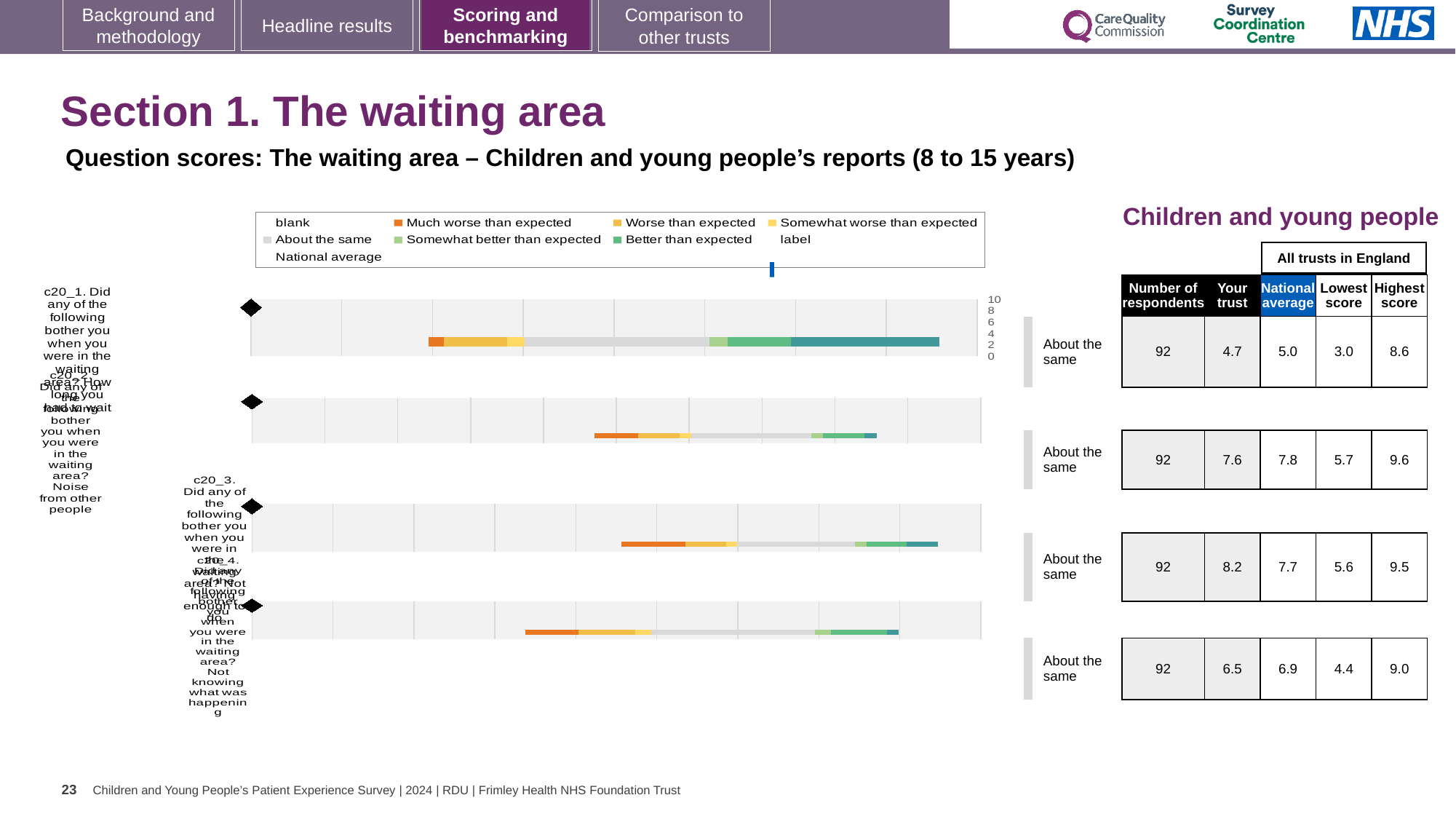
What benchmark label is shown to the right of each of the four bars? About the same What is the highest score across all trusts in England for the second row (c20_2)? 9.6 In the table beside the charts, what is the 'Your trust' score for the first row (c20_1)? 4.7 How many question rows (bars) are plotted on the slide? 4 What kind of chart is used to show the question scores on this slide? Bar chart For the fourth row (c20_4), what is the difference between the national average and the 'Your trust' score? 0.4 Which row has the lowest 'Your trust' score? First row (c20_1), 4.7 How many respondents are listed for each question row in the table? 92 Which row has the highest 'Your trust' score? Third row (c20_3), 8.2 For the third row (c20_3), which is larger: the 'Your trust' score or the national average? Your trust In the table beside the charts, what is the national average for the first row (c20_1)? 5.0 What colour does the legend use for 'Much worse than expected'? Orange